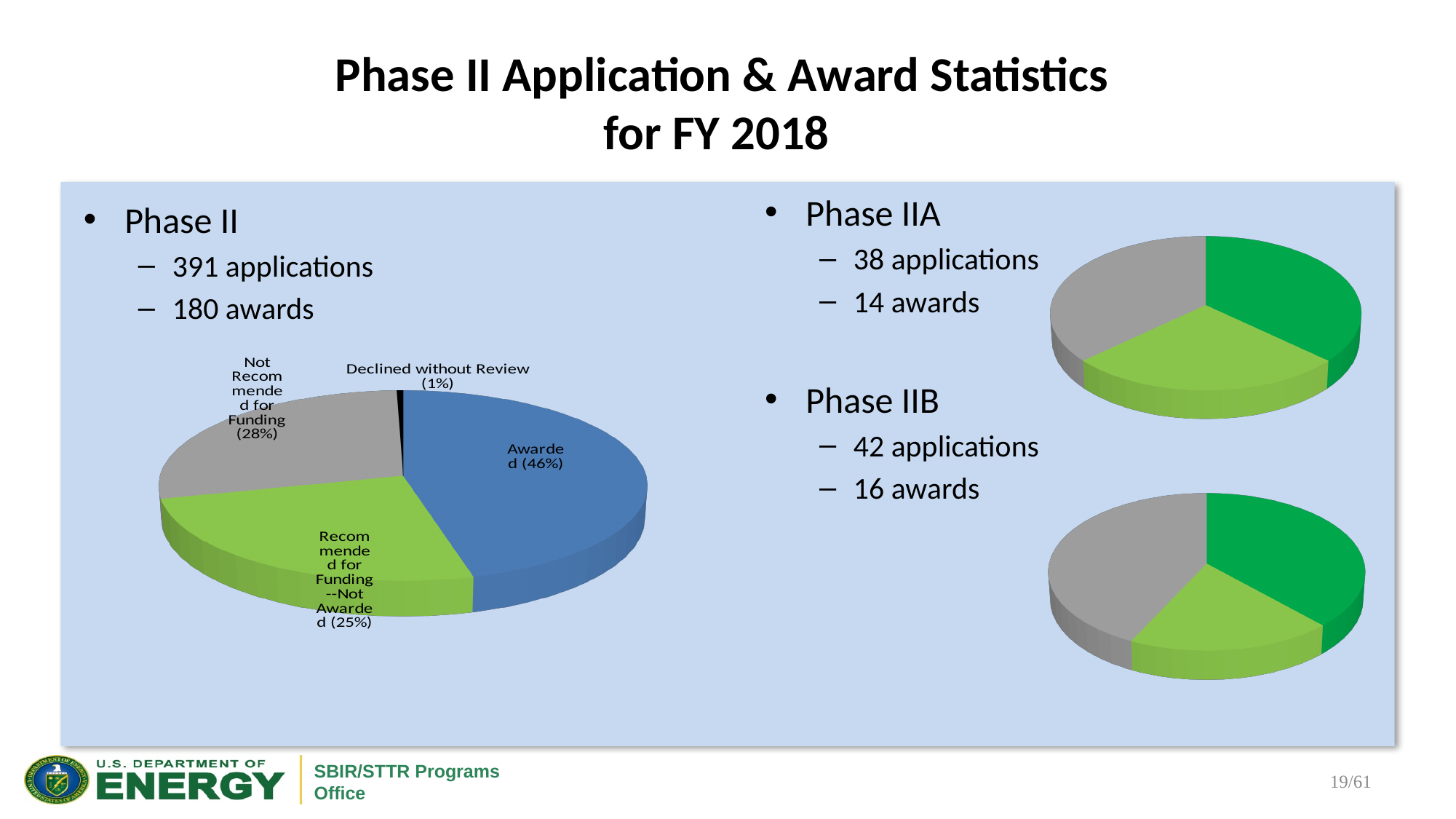
On the Phase II pie chart on the left, what share is labelled for Declined without Review? 1% On the Phase II pie chart on the left, which category has the smallest share? Declined without Review On the Phase II pie chart on the left, what share is labelled for Recommended for Funding--Not Awarded? 25% How many slices does the upper pie chart on the right (next to Phase IIA) have? 3 On the Phase II pie chart on the left, what share is labelled for Awarded? 46% On the Phase II pie chart on the left, which category has the largest share? Awarded On the Phase II pie chart on the left, what colour is the Awarded slice? Blue What kind of chart is the Phase II chart on the left? Pie chart On the Phase II pie chart on the left, which is larger: Not Recommended for Funding or Recommended for Funding--Not Awarded? Not Recommended for Funding On the Phase II pie chart on the left, what is the difference in percentage points between the Awarded share and the Not Recommended for Funding share? 18 How many slices does the Phase II pie chart on the left have? 4